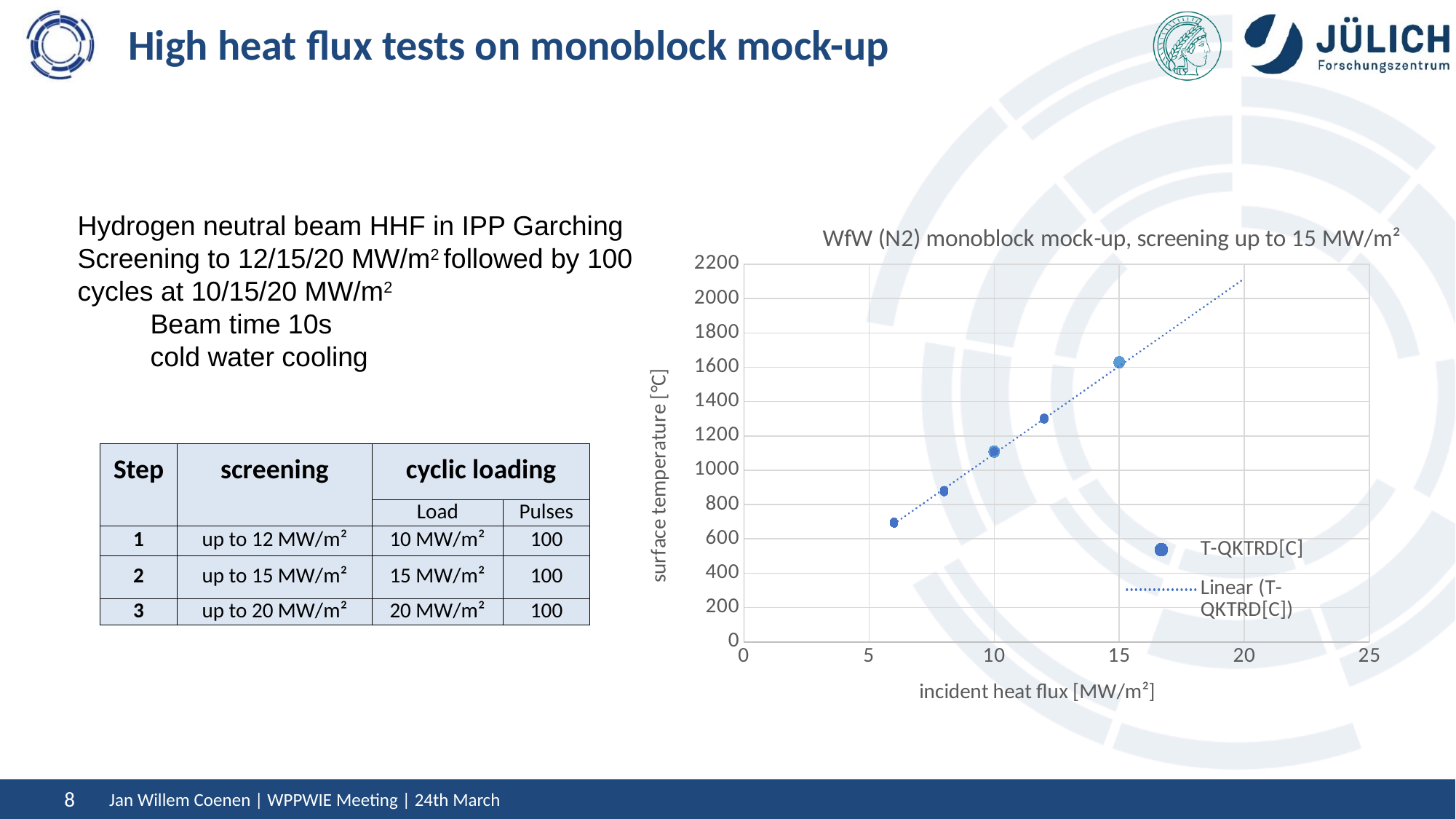
How many entries does the chart legend list? 2 Is the surface temperature at 15 MW/m² greater or less than 1400? greater Is the surface temperature at the lowest plotted heat flux greater or less than 800? less What kind of chart is shown on the slide? scatter chart What is the label of the chart's x axis? incident heat flux [MW/m²] Is the surface temperature at 12 MW/m² greater or less than 1400? less Which has the higher surface temperature: the point at 12 MW/m² or the point at 10 MW/m²? 12 MW/m² Does the surface temperature rise or fall as the incident heat flux increases? rise What is the title of the chart? WfW (N2) monoblock mock-up, screening up to 15 MW/m² At which incident heat flux is the plotted surface temperature highest? 15 MW/m²